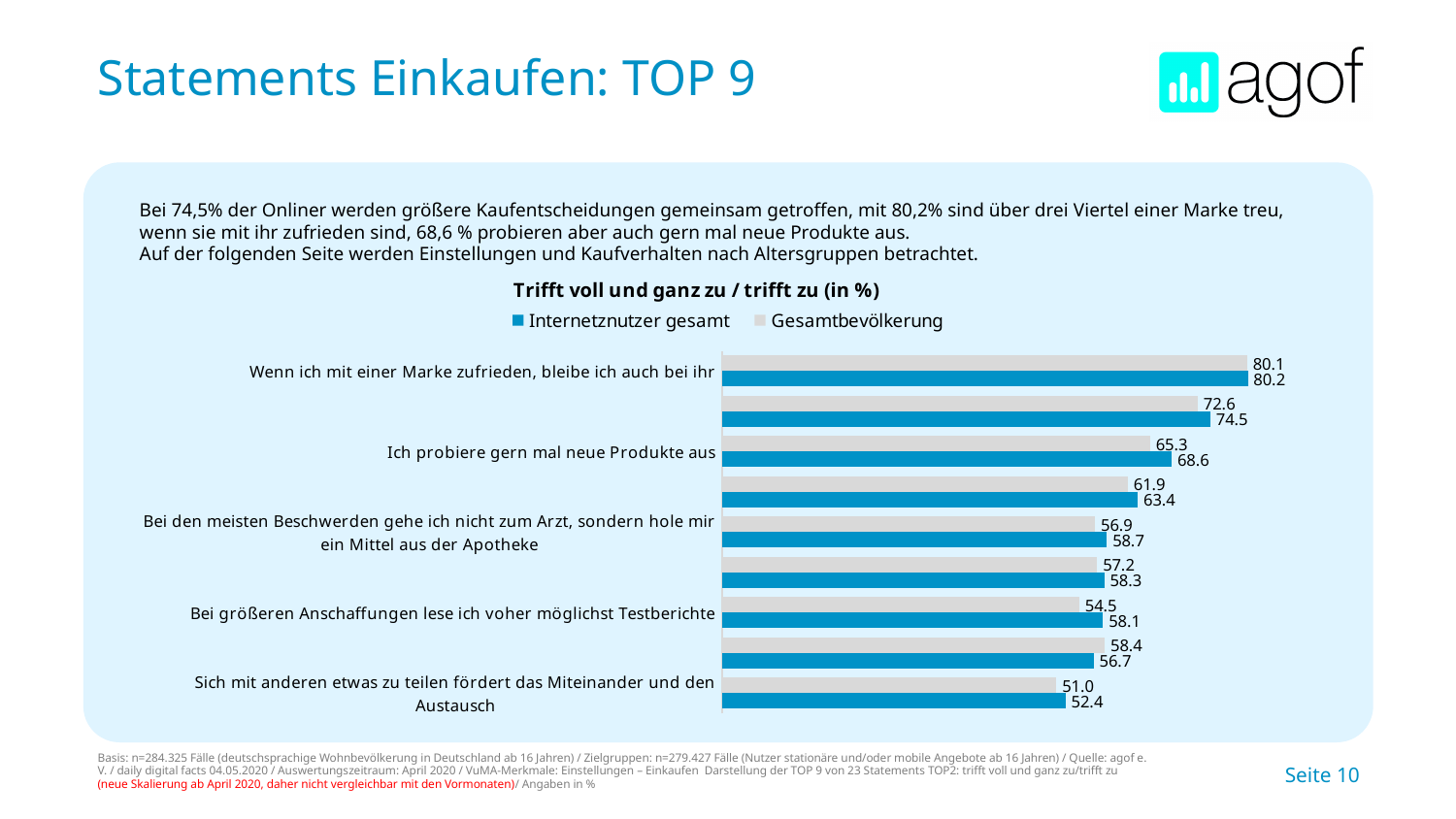
For the statement "Bei größeren Anschaffungen lese ich voher möglichst Testberichte", what is the difference between "Internetnutzer gesamt" and "Gesamtbevölkerung"? 3.6 For the statement "Sich mit anderen etwas zu teilen fördert das Miteinander und den Austausch", which series has the larger value? Internetnutzer gesamt Which statement has the highest value for "Internetnutzer gesamt"? Wenn ich mit einer Marke zufrieden, bleibe ich auch bei ihr How many statements (categories) are plotted in the chart? 9 Which statement has the lowest value for "Internetnutzer gesamt"? Sich mit anderen etwas zu teilen fördert das Miteinander und den Austausch What is the value for "Internetnutzer gesamt" for the statement "Wenn ich mit einer Marke zufrieden, bleibe ich auch bei ihr"? 80.2 What kind of chart is shown on the slide? Bar chart How many series does the legend list? 2 What is the value for "Internetnutzer gesamt" for the statement "Bei größeren Anschaffungen lese ich voher möglichst Testberichte"? 58.1 What is the value for "Gesamtbevölkerung" for the statement "Ich probiere gern mal neue Produkte aus"? 65.3 For the statement "Ich probiere gern mal neue Produkte aus", how much higher is "Internetnutzer gesamt" than "Gesamtbevölkerung"? 3.3 What is the value for "Gesamtbevölkerung" for the statement "Bei den meisten Beschwerden gehe ich nicht zum Arzt, sondern hole mir ein Mittel aus der Apotheke"? 56.9